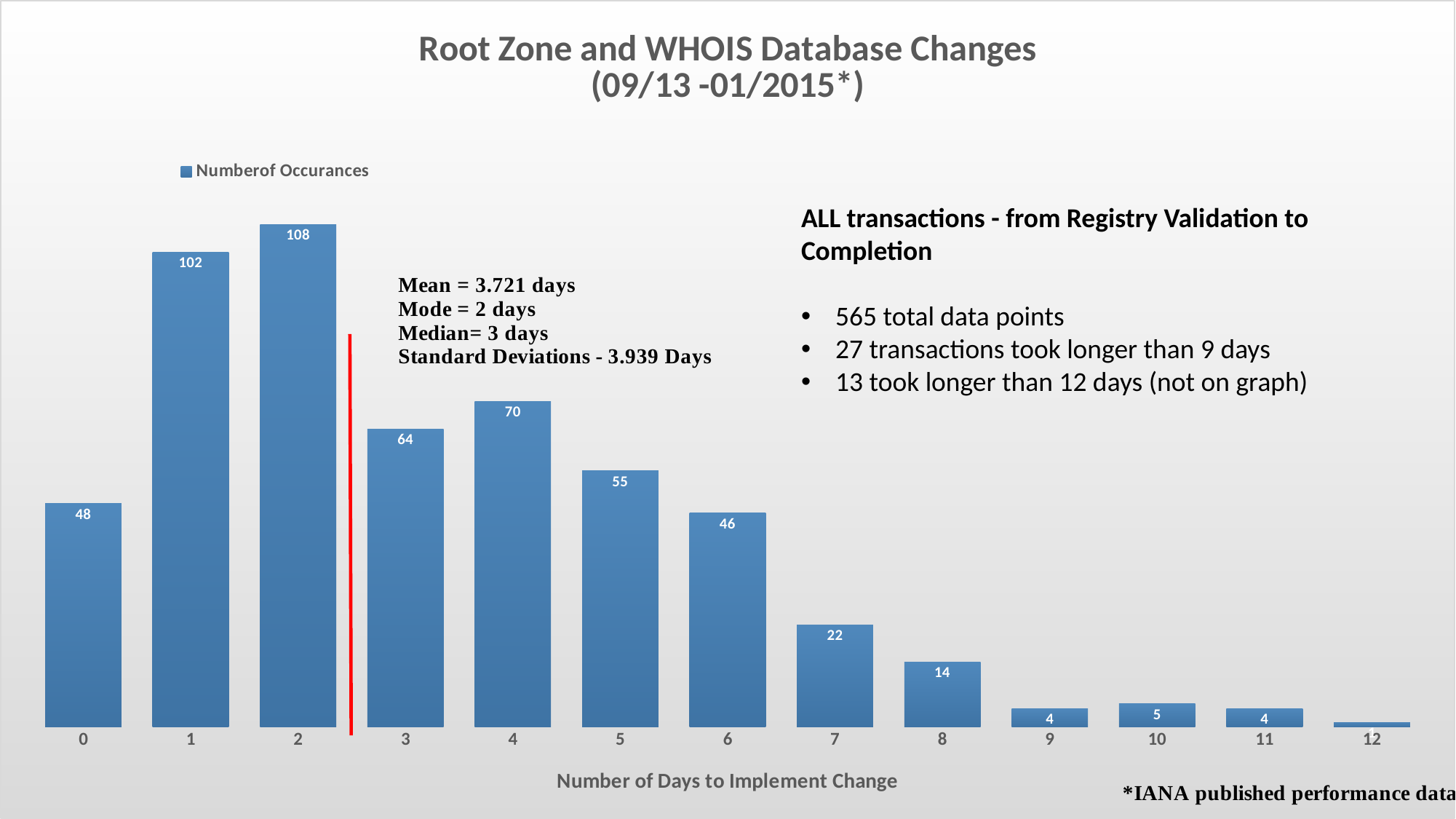
What is the number of occurrences for 2 days to implement change? 108 How many series does the legend list? 1 What is the number of occurrences for 7 days to implement change? 22 What is the number of occurrences for 10 days to implement change? 5 How many bars (day categories) are shown on the chart? 13 Which number of days has the highest number of occurrences? 2 Which number of days has the lowest number of occurrences? 12 What kind of chart is shown on the slide? Bar chart What is the difference in occurrences between 0 days and 7 days? 26 What is the difference in occurrences between 2 days and 1 day? 6 What is the number of occurrences for 0 days to implement change? 48 Which has more occurrences, 3 days or 4 days? 4 days